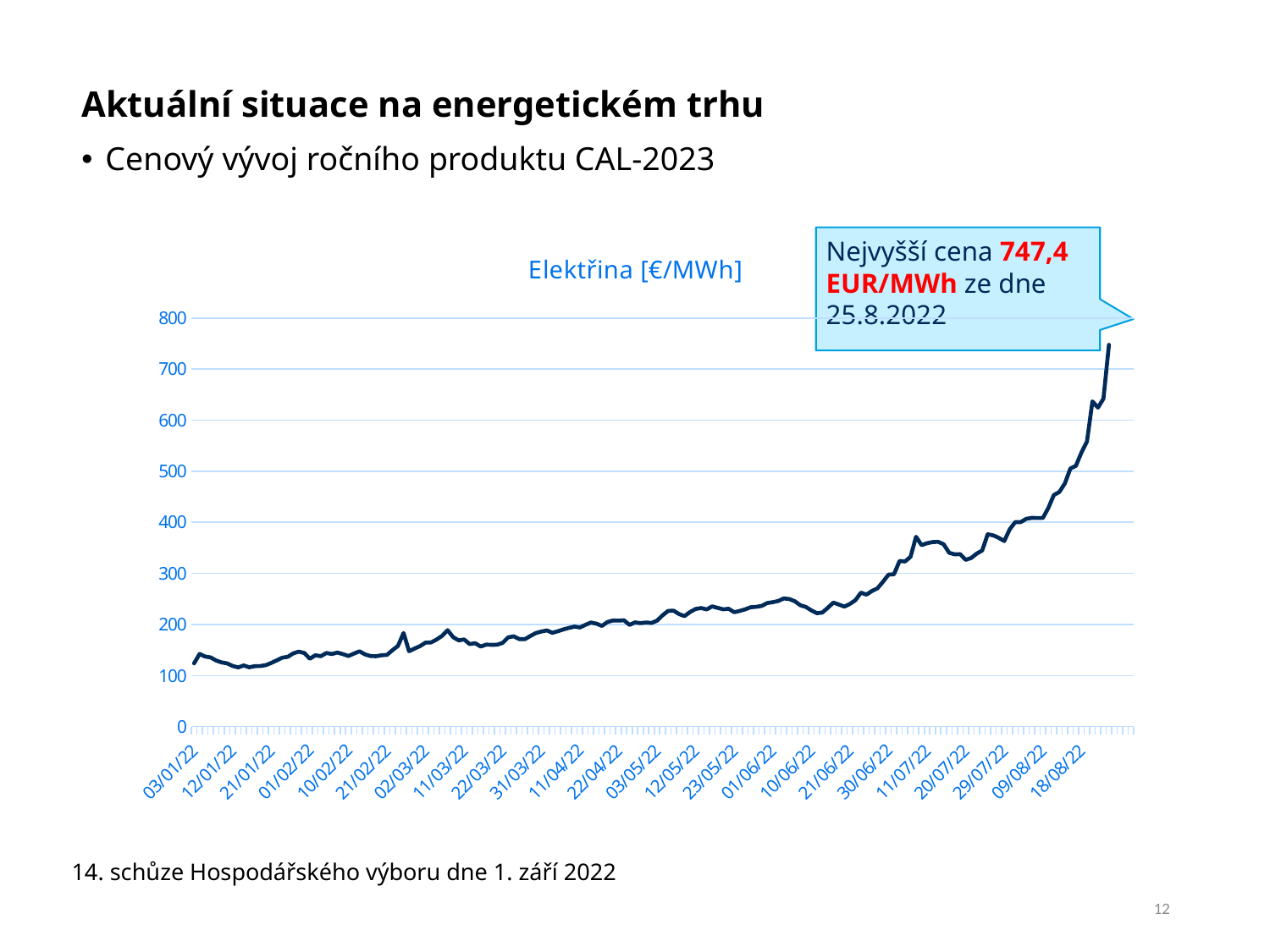
Is the value for 21/01/22 greater or less than 200? less On which date was the highest price of 747,4 EUR/MWh reached? 25.8.2022 What kind of chart is shown on the slide? line chart Which is larger, the value for 03/01/22 or the value for 18/08/22? 18/08/22 What is the title of the chart? Elektřina [€/MWh] What is the highest price shown on the slide? 747,4 EUR/MWh Do the values generally rise or fall along the x axis from 03/01/22 to the end of the series? rise Is the value for 18/08/22 greater or less than 500? greater Is the value for 11/07/22 greater or less than 300? greater What is the first date label shown on the x axis? 03/01/22